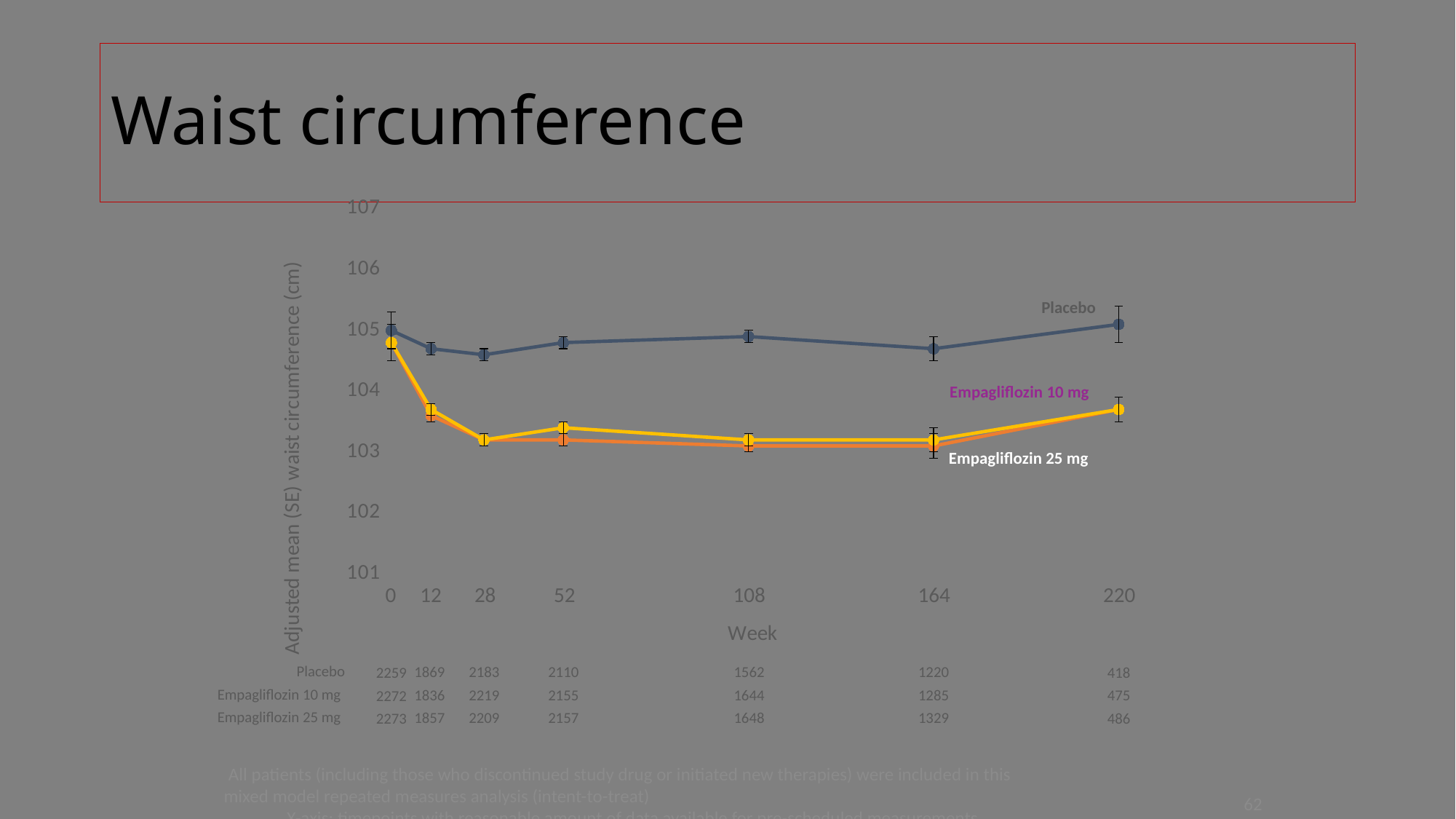
What is the y-axis label of the chart? Adjusted mean (SE) waist circumference (cm) How many series are plotted on the chart? 3 According to the patient numbers table below the chart, how many Empagliflozin 25 mg patients are listed at week 0? 2273 According to the patient numbers table below the chart, how many Placebo patients are listed at week 220? 418 Does the Empagliflozin 25 mg line rise or fall from week 0 to week 28? fall Which series has the highest waist circumference at week 220? Placebo Is the value for Empagliflozin 10 mg at week 28 greater or less than 104? less At week 52, which is larger: the value for Placebo or the value for Empagliflozin 25 mg? Placebo What kind of chart is shown on the slide? line chart How many week timepoints are shown on the x axis? 7 Is the value for Placebo at week 28 greater or less than 104? greater